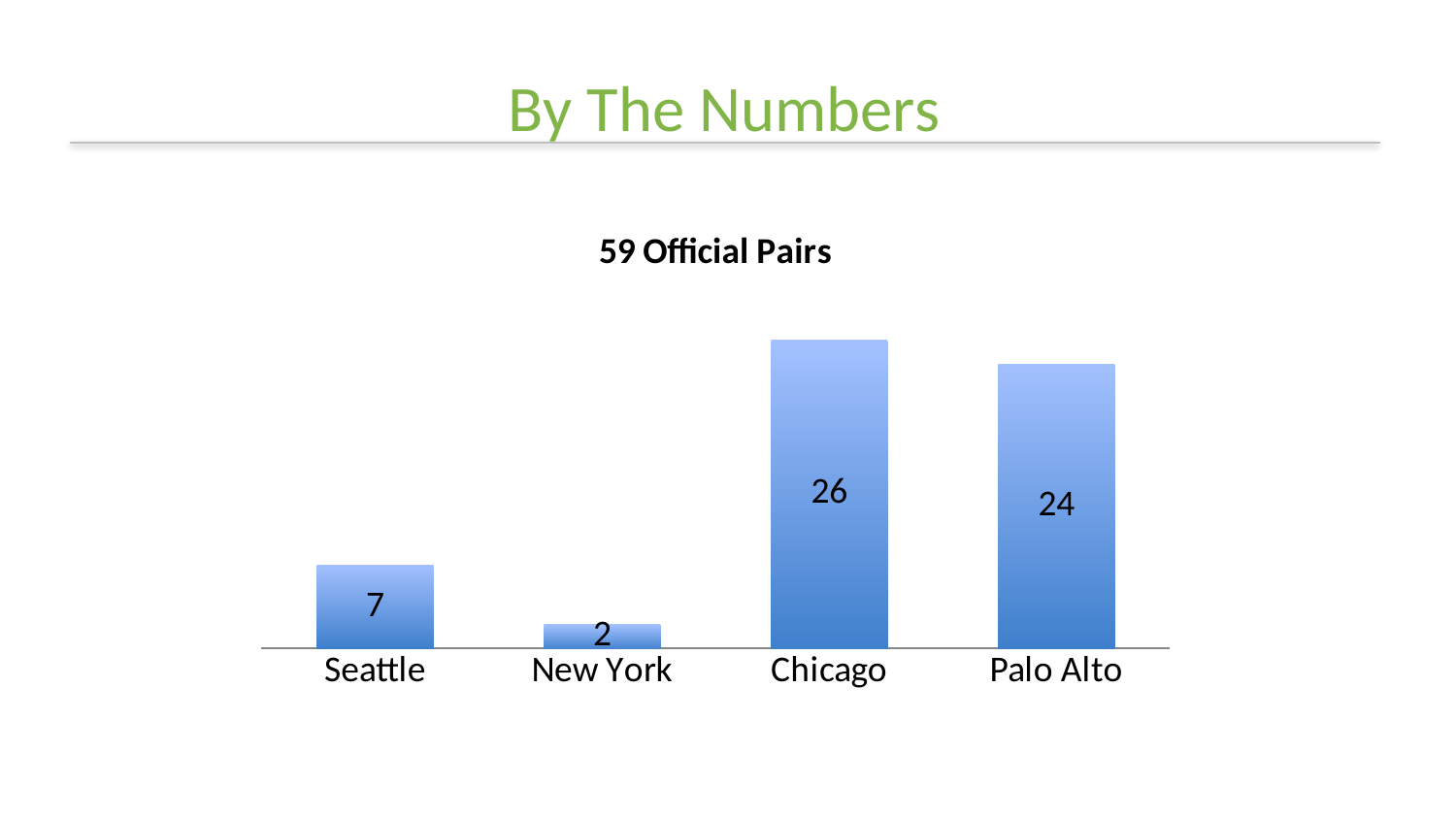
Which category has the lowest value? New York Which category has the highest value? Chicago What is the difference between the values for Chicago and Palo Alto? 2 What is the value for Chicago? 26 What is the value for Seattle? 7 How many categories are shown on the x axis? 4 What is the value for New York? 2 What kind of chart is shown on the slide? Bar chart What is the value for Palo Alto? 24 Which is larger, the value for Seattle or the value for Palo Alto? Palo Alto What is the title of the chart? 59 Official Pairs What is the difference between the values for Seattle and New York? 5